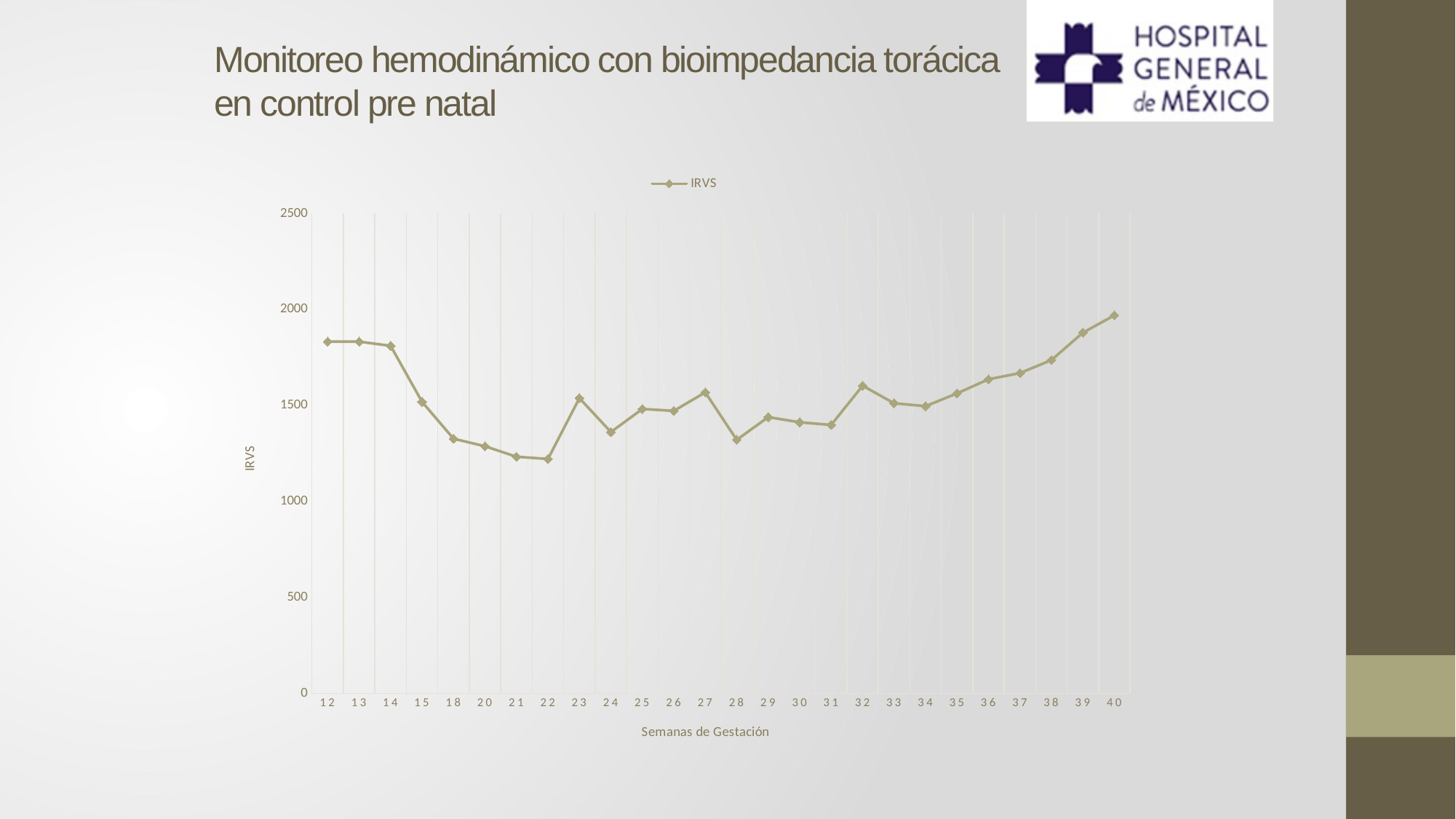
What kind of chart is shown on the slide? line chart Is the IRVS value at week 22 greater or less than 1500? less What is the name of the series shown in the legend? IRVS Is the IRVS value at week 40 greater or less than 2000? less Is the IRVS value at week 28 greater or less than 1500? less What is the title of the x axis? Semanas de Gestación Do the IRVS values rise or fall from week 34 to week 40? rise Which has the larger IRVS value, week 12 or week 22? week 12 At which gestation week is the IRVS value highest? 40 How many gestation weeks are plotted along the x axis? 26 How many series does the legend list? 1